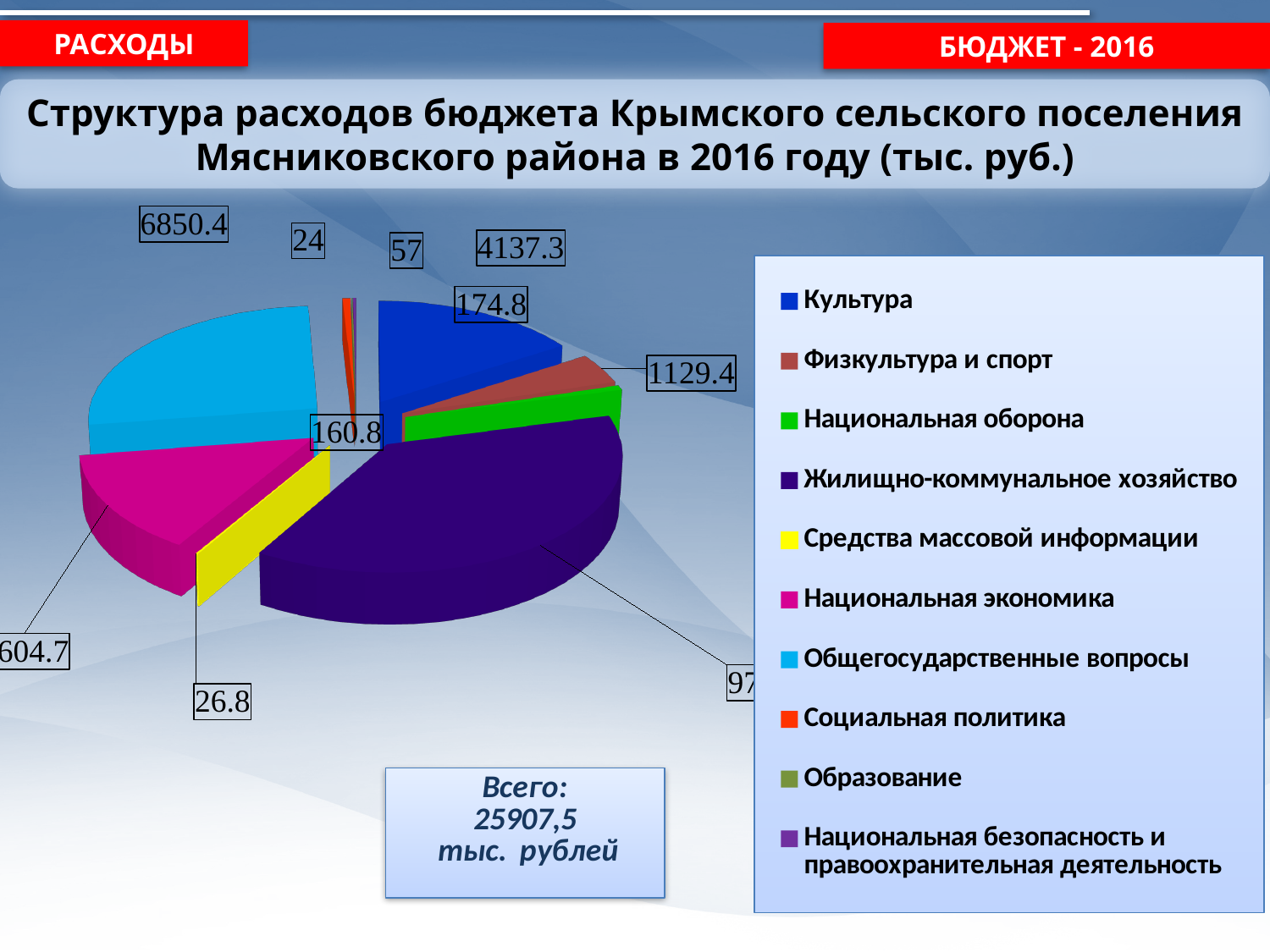
What is the value shown for Средства массовой информации? 26.8 What total (Всего) is stated on the slide for the budget expenditures? 25907,5 тыс. рублей What colour is used for Культура in the legend? blue What is the value shown for Культура? 4137.3 How many categories does the legend of the pie chart list? 10 Which is larger, the value for Культура or the value for Общегосударственные вопросы? Общегосударственные вопросы Which category has the largest slice of the pie? Жилищно-коммунальное хозяйство What is the difference between the values for Общегосударственные вопросы and Культура? 2713.1 What kind of chart is shown on the slide? pie chart What is the difference between the values for Культура and Средства массовой информации? 4110.5 What is the title of the chart on the slide? Структура расходов бюджета Крымского сельского поселения Мясниковского района в 2016 году (тыс. руб.) What is the value shown for Общегосударственные вопросы? 6850.4